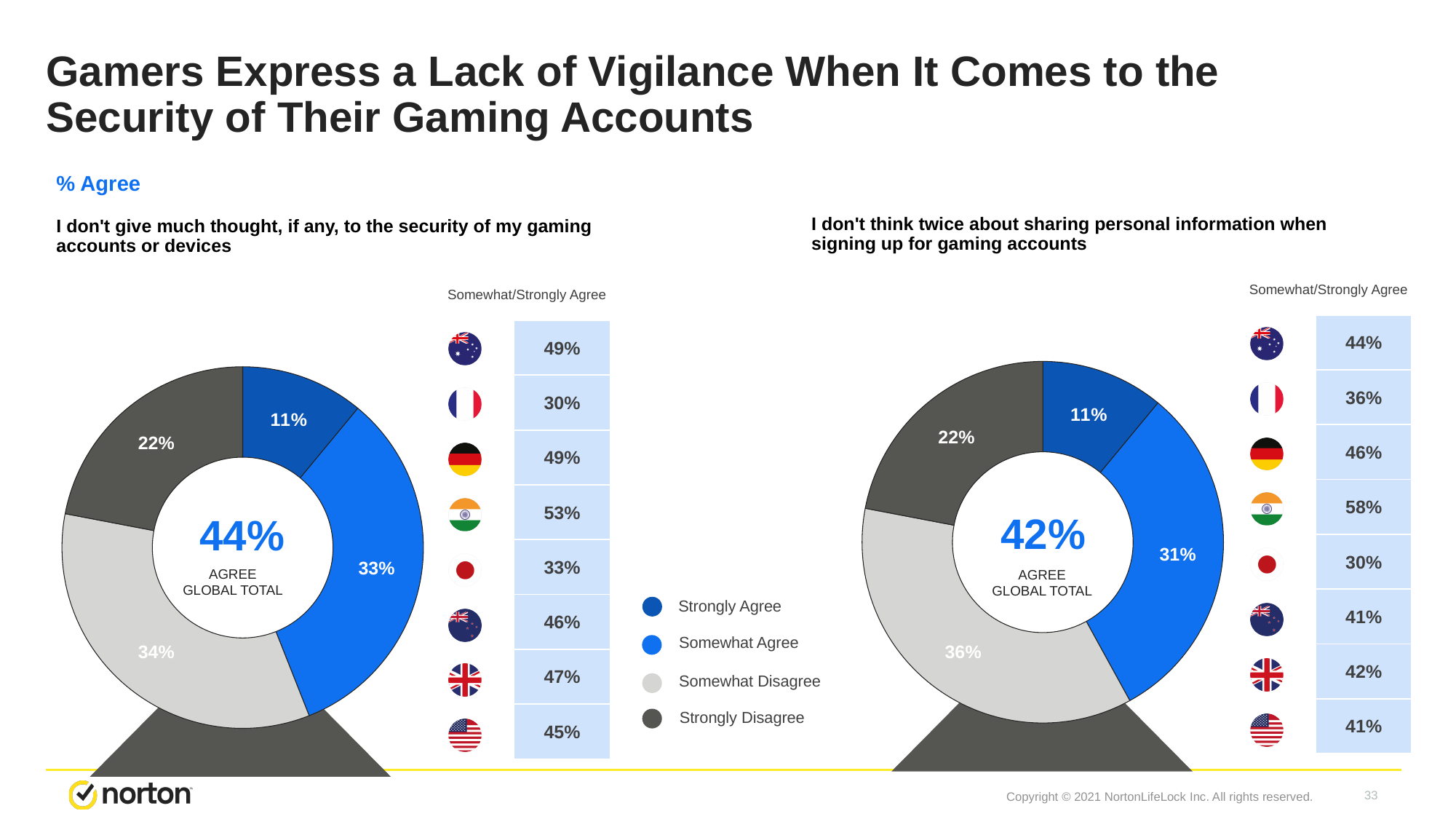
In the right donut chart ('I don't think twice about sharing personal information...'), what is the difference between Somewhat Disagree and Strongly Disagree? 14% In the left donut chart ('I don't give much thought...'), which response category has the smallest share? Strongly Agree In the left donut chart ('I don't give much thought...'), what is the value for Somewhat Disagree? 34% In the right donut chart ('I don't think twice about sharing personal information...'), which response category has the largest share? Somewhat Disagree Which is larger: Somewhat Agree in the left donut chart or Somewhat Agree in the right donut chart? Left donut chart (33%) In the left donut chart ('I don't give much thought...'), what is the Agree Global Total shown in the centre? 44% What kind of chart is used on the left for 'I don't give much thought, if any, to the security of my gaming accounts or devices'? Donut (pie) chart In the Somewhat/Strongly Agree country table next to the right donut chart, what is the highest percentage listed? 58% In the left donut chart ('I don't give much thought...'), what is the value for Somewhat Agree? 33% In the right donut chart ('I don't think twice about sharing personal information...'), what is the value for Somewhat Agree? 31% How many response categories does the legend list for the donut charts? 4 In the right donut chart ('I don't think twice about sharing personal information...'), what is the Agree Global Total shown in the centre? 42%